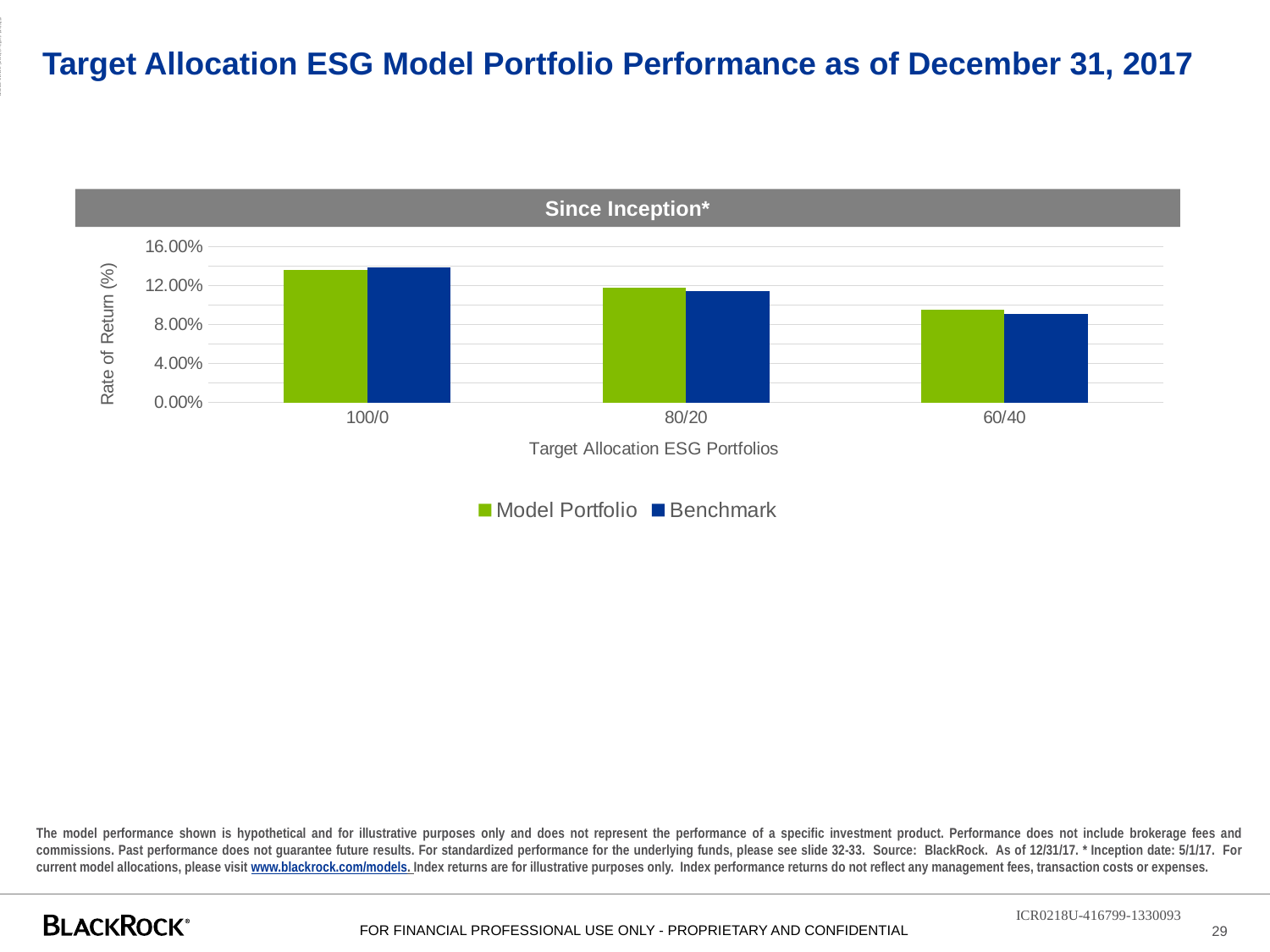
Do the Model Portfolio values rise or fall moving from 100/0 to 60/40 along the x axis? fall What kind of chart is shown on the slide? bar chart Which is larger, the Model Portfolio value for 100/0 or the Model Portfolio value for 60/40? 100/0 Which portfolio has the highest Model Portfolio rate of return? 100/0 Is the Benchmark value for 60/40 greater or less than 12.00%? less Is the Benchmark value for 100/0 greater or less than 16.00%? less How many portfolio categories are shown on the x axis? 3 Which portfolio has the lowest Benchmark rate of return? 60/40 Is the Model Portfolio value for 100/0 greater or less than 12.00%? greater What is the label on the y axis of the chart? Rate of Return (%) How many series does the legend list? 2